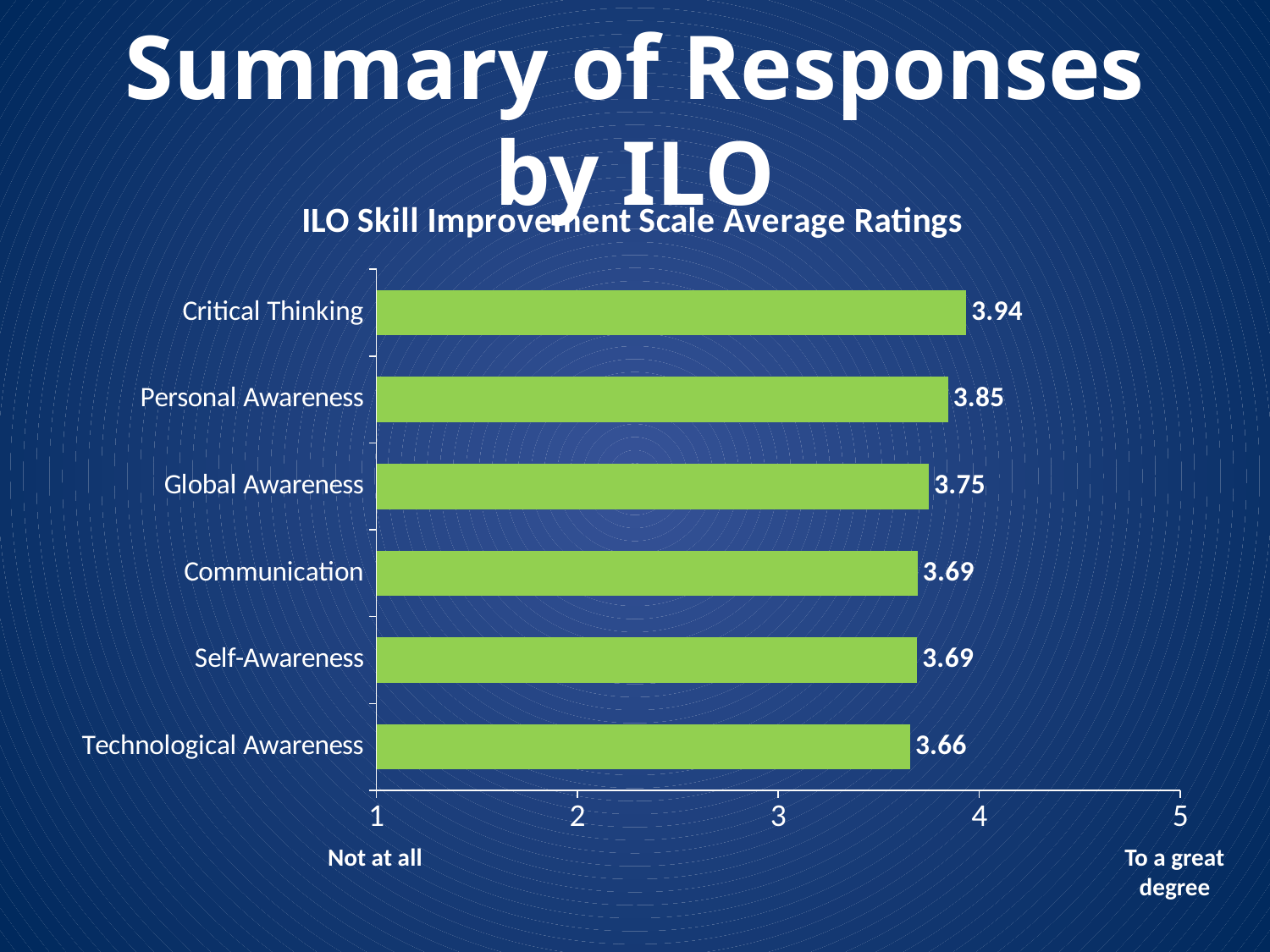
Which has a higher average rating, Personal Awareness or Communication? Personal Awareness What is the average rating for Global Awareness? 3.75 Which ILO skill has the lowest average rating? Technological Awareness What is the average rating for Technological Awareness? 3.66 What kind of chart is shown on the slide? Bar chart What is the difference between the average ratings for Critical Thinking and Technological Awareness? 0.28 Which ILO skill has the highest average rating? Critical Thinking What is the difference between the average ratings for Personal Awareness and Global Awareness? 0.10 What is the title of the chart? ILO Skill Improvement Scale Average Ratings What is the average rating for Critical Thinking? 3.94 Is the value for Critical Thinking greater or less than 4? less How many ILO skills are shown in the chart? 6